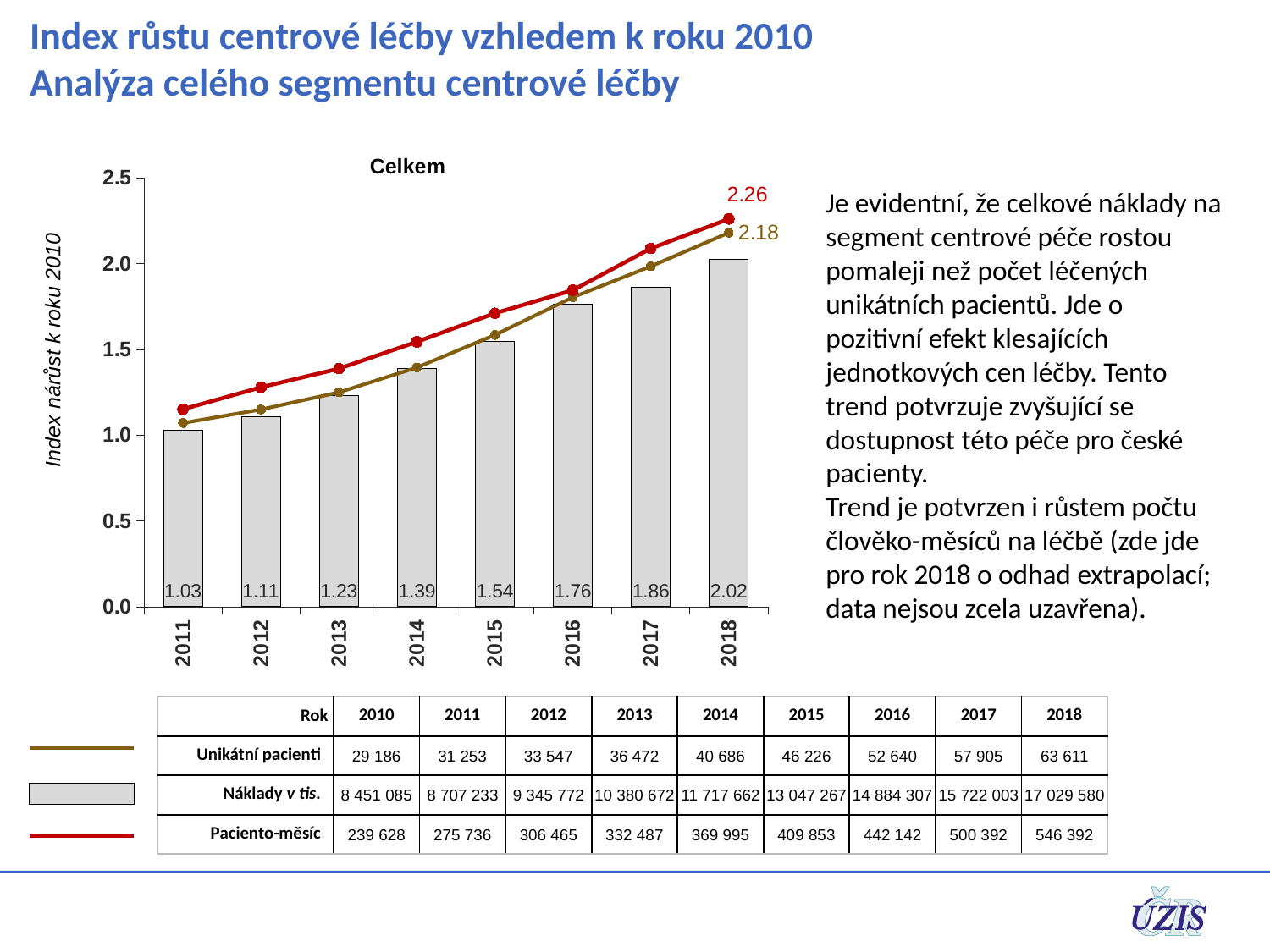
Which year has the lowest bar value? 2011 In 2018, which is larger: the red line value or the brown line value? the red line (2.26) What is the value of the bar for 2011? 1.03 What is the difference between the bar values for 2018 and 2011? 0.99 Is the value of the red line for 2017 greater or less than 2.0? greater What is the value of the bar for 2018? 2.02 How many years are shown on the x axis of the chart? 8 What is the value of the bar for 2015? 1.54 What value does the brown line (Unikátní pacienti) reach in 2018? 2.18 Do the bar values rise or fall from 2011 to 2018? rise Which year has the highest bar value? 2018 What value does the red line (Paciento-měsíc) reach in 2018? 2.26